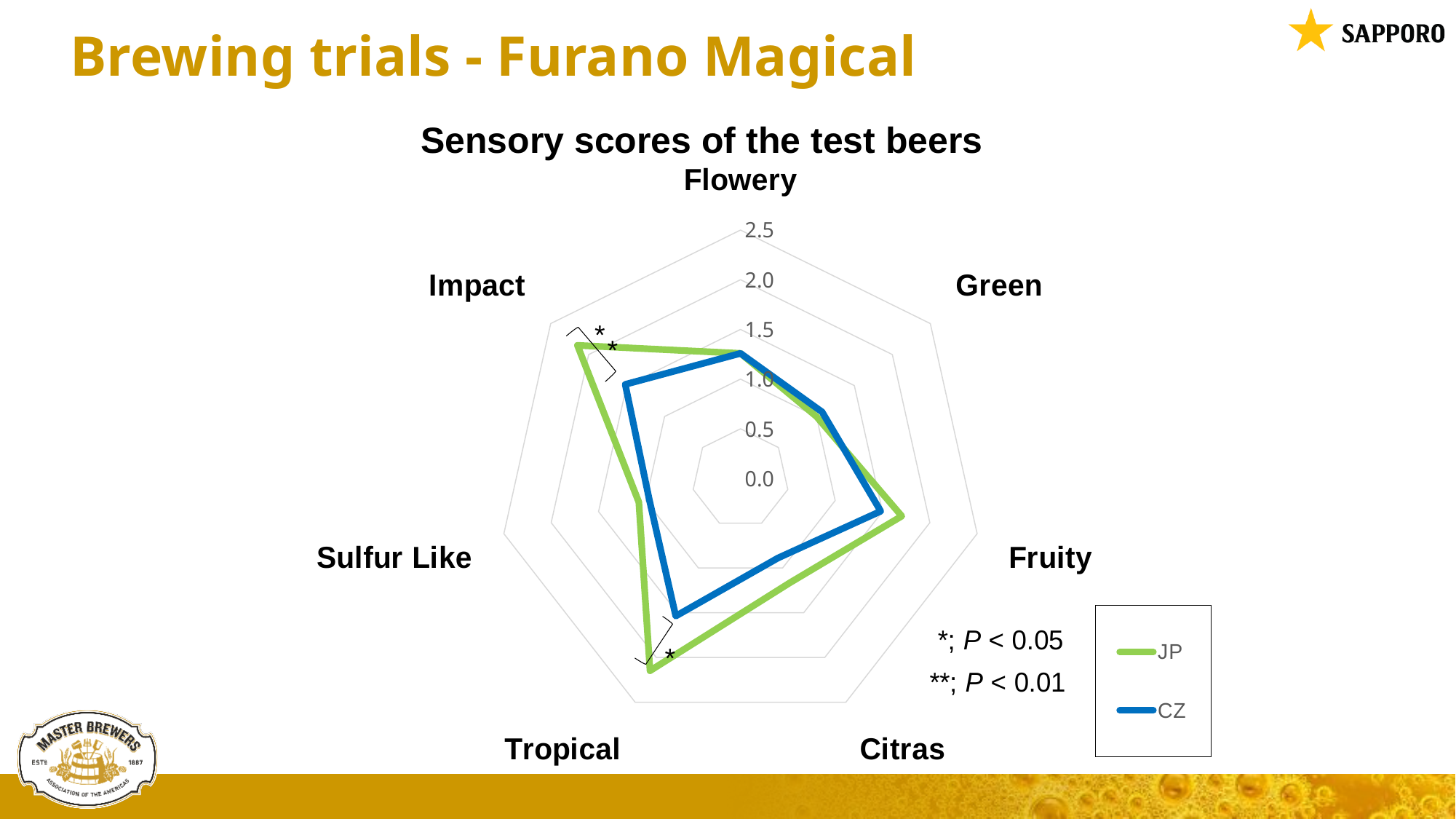
Which series has the higher score for Impact, JP or CZ? JP What is the title of the chart? Sensory scores of the test beers Which series has the higher score for Tropical, JP or CZ? JP How many series does the legend list? 2 Is the JP value for Tropical greater or less than 2.0? greater How many sensory attributes (categories) are plotted on the radar chart? 7 Which series is drawn in green? JP Is the CZ value for Citras greater or less than 1.0? less Is the JP value for Impact greater or less than 2.0? greater Which series has the higher score for Citras, JP or CZ? JP What kind of chart is shown on the slide? Radar chart